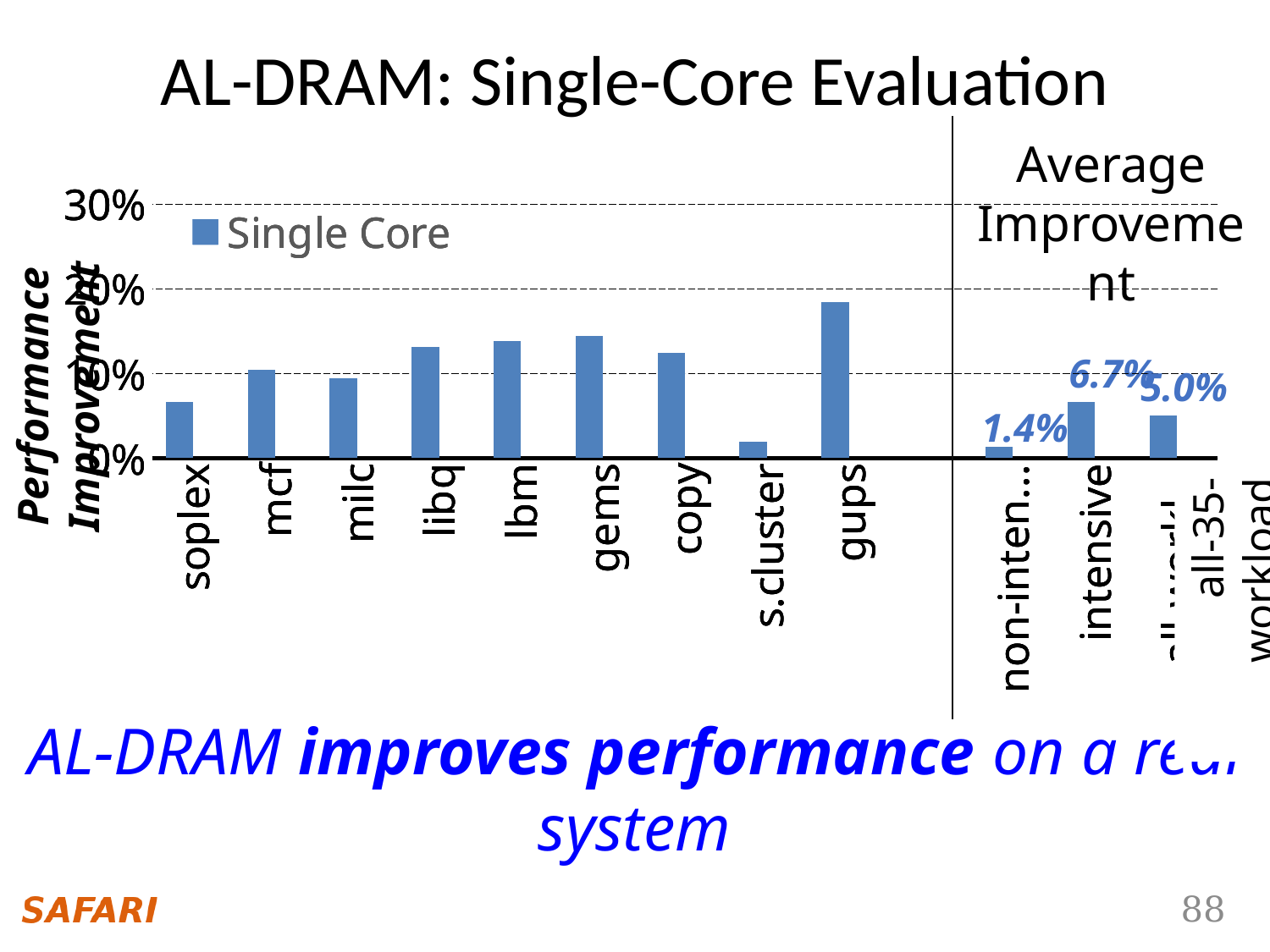
What is the average performance improvement shown for the intensive workloads? 6.7% Which individual benchmark (left of the vertical divider) has the lowest performance improvement? s.cluster What is the name of the series listed in the legend? Single Core Which individual benchmark (left of the vertical divider) has the highest performance improvement? gups Is the performance improvement for gups greater or less than 10%? greater What kind of chart is shown on the slide? bar chart What is the average performance improvement shown for the non-intensive workloads? 1.4% What is the average performance improvement shown for all 35 workloads? 5.0% What is the difference between the average improvement for intensive workloads and for non-intensive workloads? 5.3% How many series does the legend list? 1 Is the performance improvement for soplex greater or less than 10%? less Which has a larger performance improvement, gups or copy? gups